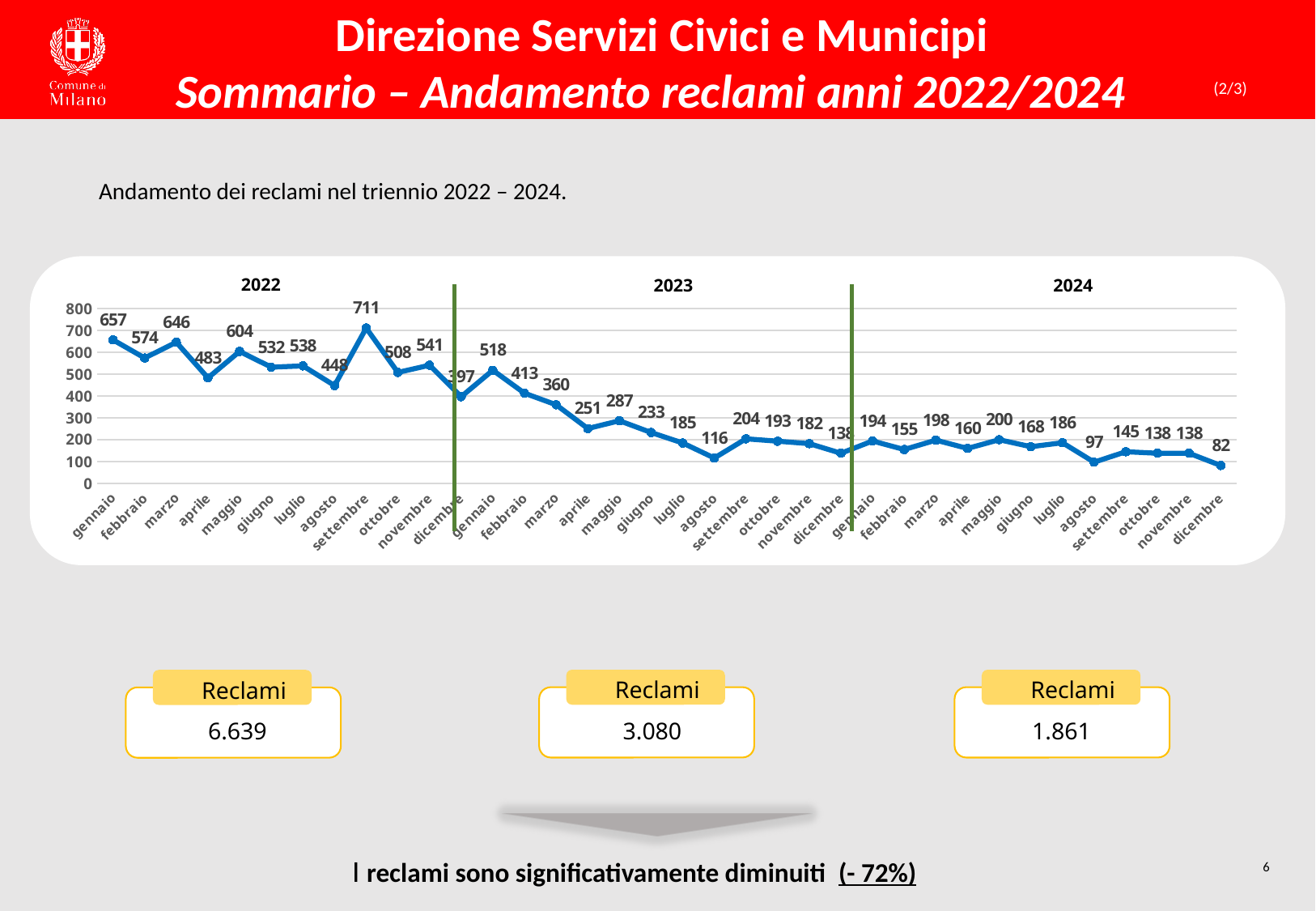
What is the difference between the values for agosto 2024 and dicembre 2024? 15 Do the values generally rise or fall from gennaio 2022 to dicembre 2024? fall What is the difference between the values for gennaio 2022 and gennaio 2023? 139 Which month has the lowest value in the chart? dicembre 2024 What is the value for dicembre 2024? 82 What kind of chart is shown on the slide? line chart Is the value for marzo 2022 greater or less than 600? greater Which is larger, the value for maggio 2023 or the value for maggio 2024? maggio 2023 What is the value for agosto 2023? 116 How many monthly data points are plotted in the chart? 36 What is the value for settembre 2022? 711 Which month has the highest value in the chart? settembre 2022